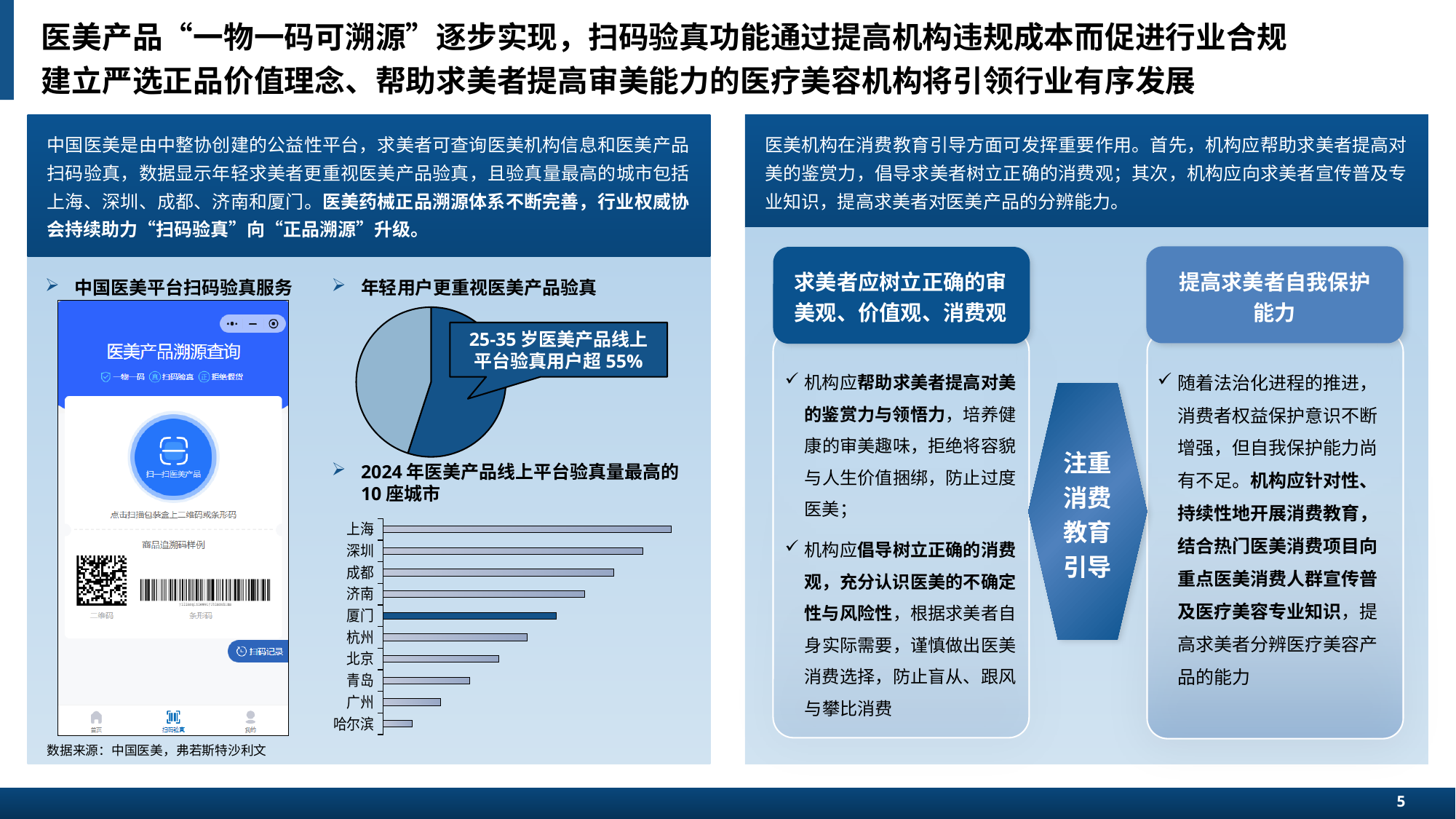
In the bar chart of 2024 verification volume by city, which city's bar is highlighted in dark blue? 厦门 How many cities are shown in the bar chart of 2024 online platform verification volume? 10 What kind of chart is used to show the 2024 top 10 cities for online medical aesthetics product verification volume? bar chart In the bar chart of 2024 verification volume by city, which city has the highest value? 上海 In the bar chart of 2024 verification volume by city, do the values rise or fall going from 上海 at the top to 哈尔滨 at the bottom? fall In the bar chart of 2024 verification volume by city, which city has the lowest value? 哈尔滨 According to the callout on the pie chart, what share of online platform verification users are aged 25-35? 超 55% In the bar chart of 2024 verification volume by city, which has the larger value, 深圳 or 青岛? 深圳 What kind of chart is used under the heading 年轻用户更重视医美产品验真? pie chart In the bar chart of 2024 verification volume by city, which has the larger value, 北京 or 广州? 北京 How many slices does the pie chart under 年轻用户更重视医美产品验真 have? 2